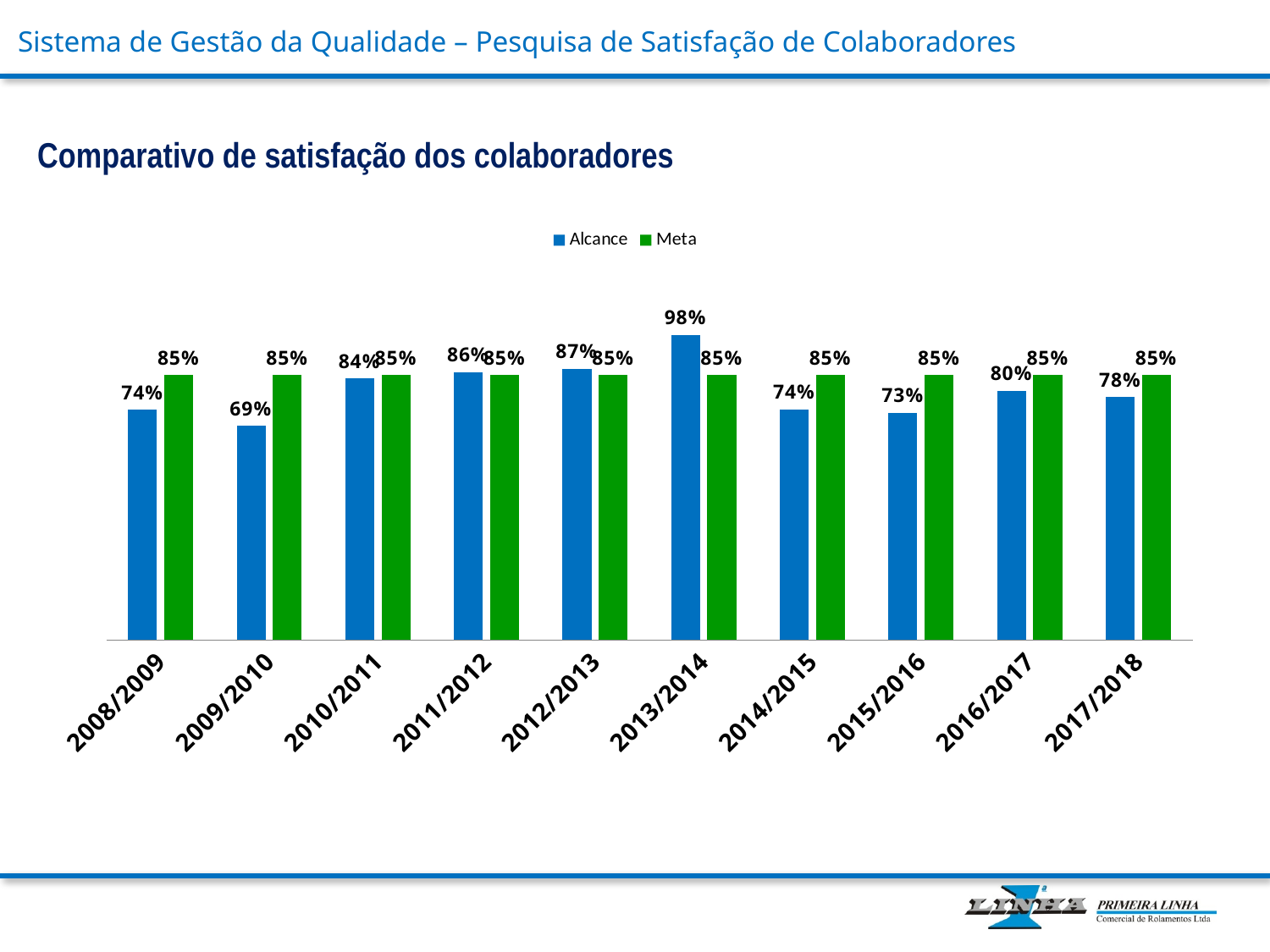
What kind of chart is shown on the slide? Bar chart How many series does the legend list? 2 How many periods are shown on the x axis? 10 What is the difference between the Alcance and Meta values for 2013/2014? 13% Which period has the highest Alcance value? 2013/2014 What is the Alcance value for 2009/2010? 69% What is the Alcance value for 2013/2014? 98% Which period has the lowest Alcance value? 2009/2010 What is the difference between the Alcance values for 2016/2017 and 2015/2016? 7% Which is larger for 2012/2013, Alcance or Meta? Alcance What is the Meta value for 2017/2018? 85% Which is larger for 2014/2015, Alcance or Meta? Meta